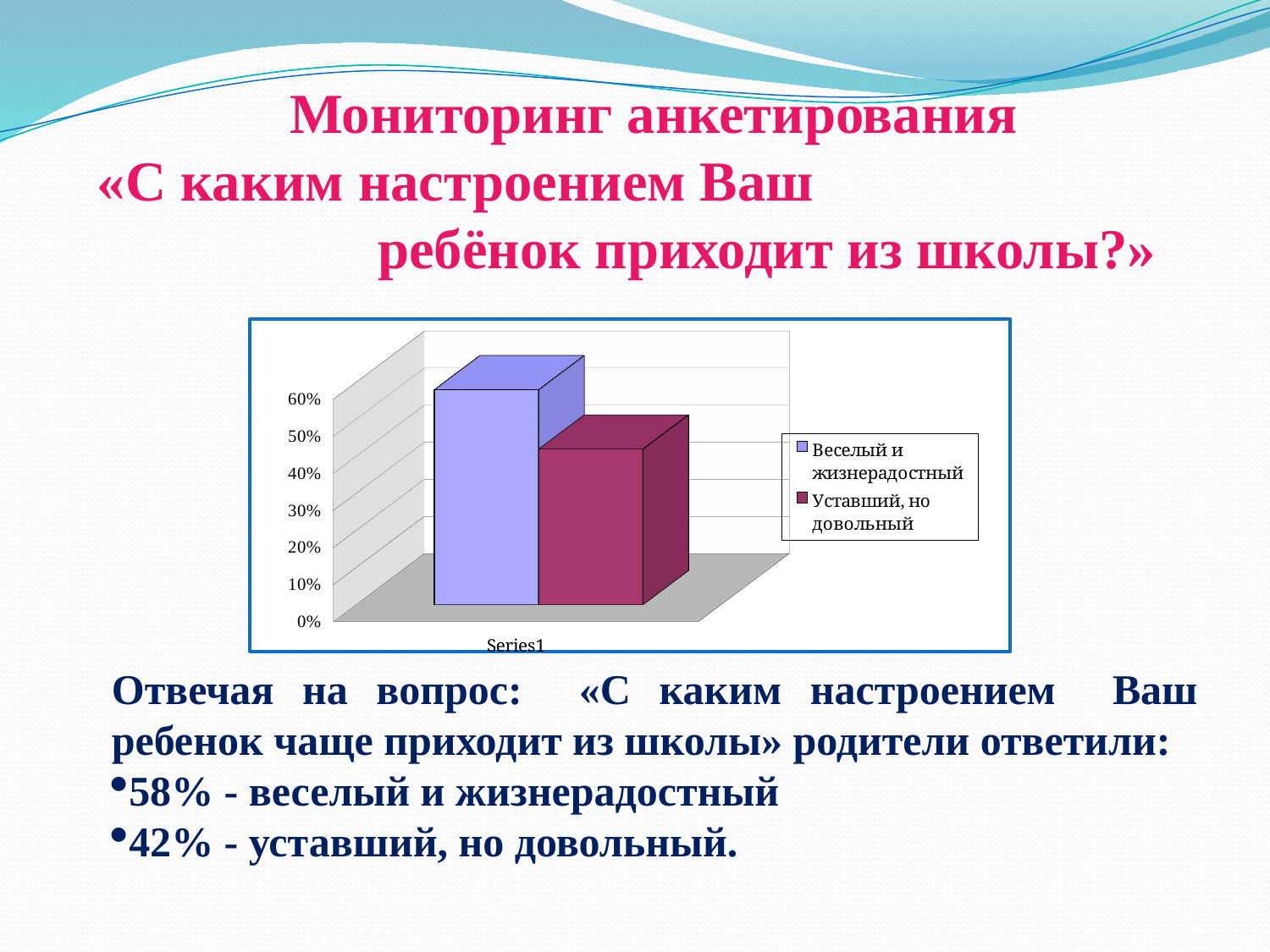
According to the slide, what percentage of parents answered "веселый и жизнерадостный"? 58% Is the bar for "Веселый и жизнерадостный" greater or less than 50%? greater How many series does the chart legend list? 2 According to the slide, what percentage of parents answered "уставший, но довольный"? 42% Which series has the taller bar in the chart? Веселый и жизнерадостный Which is larger: the bar for "Веселый и жизнерадостный" or the bar for "Уставший, но довольный"? Веселый и жизнерадостный What is the highest value shown on the chart's vertical axis? 60% Which series has the shorter bar in the chart? Уставший, но довольный What is the difference between the share answering "веселый и жизнерадостный" and the share answering "уставший, но довольный"? 16% Is the bar for "Уставший, но довольный" greater or less than 50%? less Is the bar for "Уставший, но довольный" greater or less than 30%? greater What kind of chart is shown on the slide? bar chart